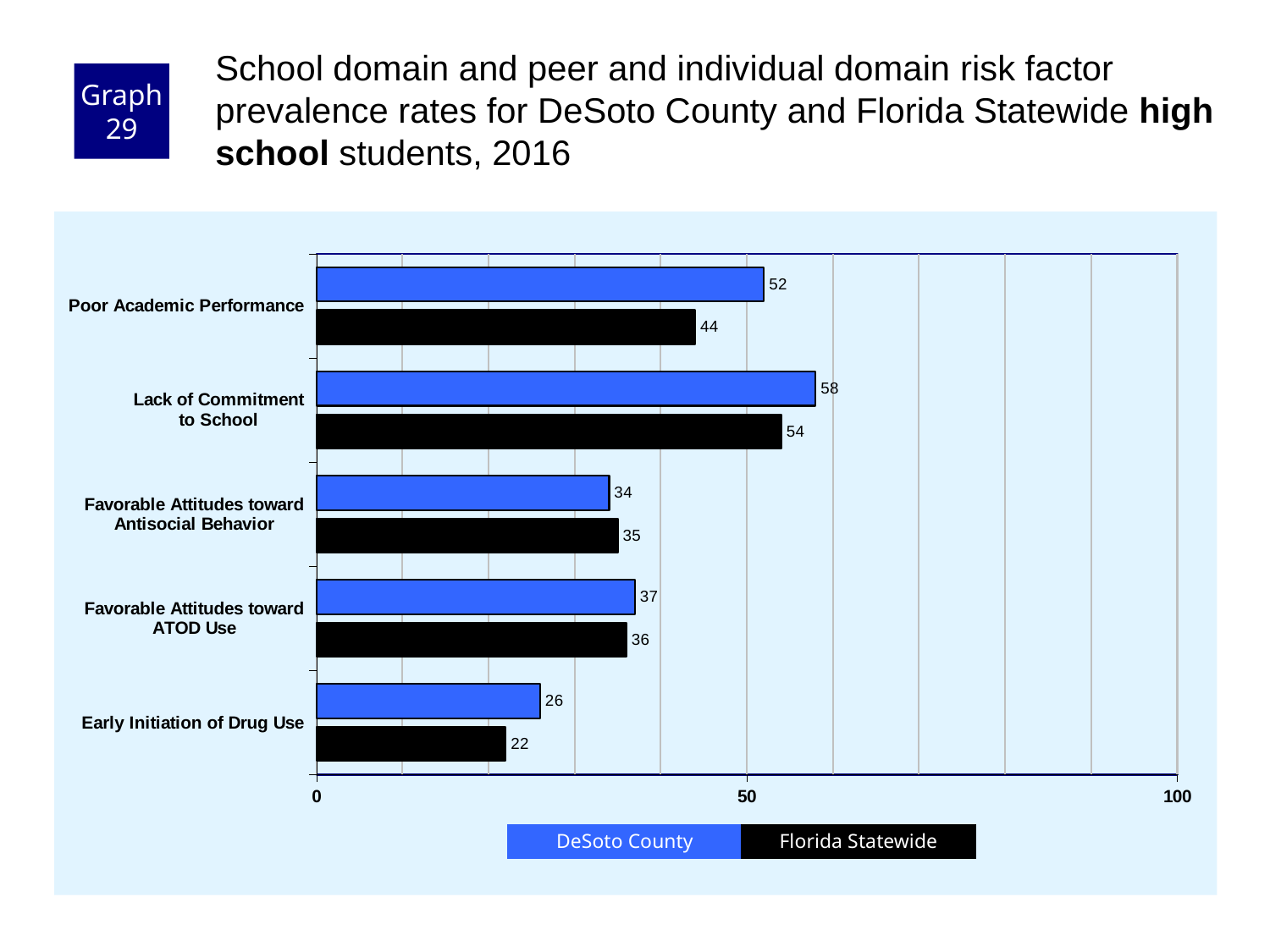
What is the difference between the DeSoto County and Florida Statewide values for Poor Academic Performance? 8 What is the DeSoto County value for Poor Academic Performance? 52 Is the DeSoto County value for Lack of Commitment to School greater or less than 50? greater For Favorable Attitudes toward Antisocial Behavior, which is larger: the DeSoto County value or the Florida Statewide value? Florida Statewide What kind of chart is shown on the slide? bar chart How many risk factor categories are shown on the chart? 5 Which risk factor has the lowest Florida Statewide value? Early Initiation of Drug Use How many series does the legend list? 2 What is the Florida Statewide value for Early Initiation of Drug Use? 22 Which colour represents Florida Statewide in the chart? black Which risk factor has the highest DeSoto County value? Lack of Commitment to School What is the Florida Statewide value for Lack of Commitment to School? 54